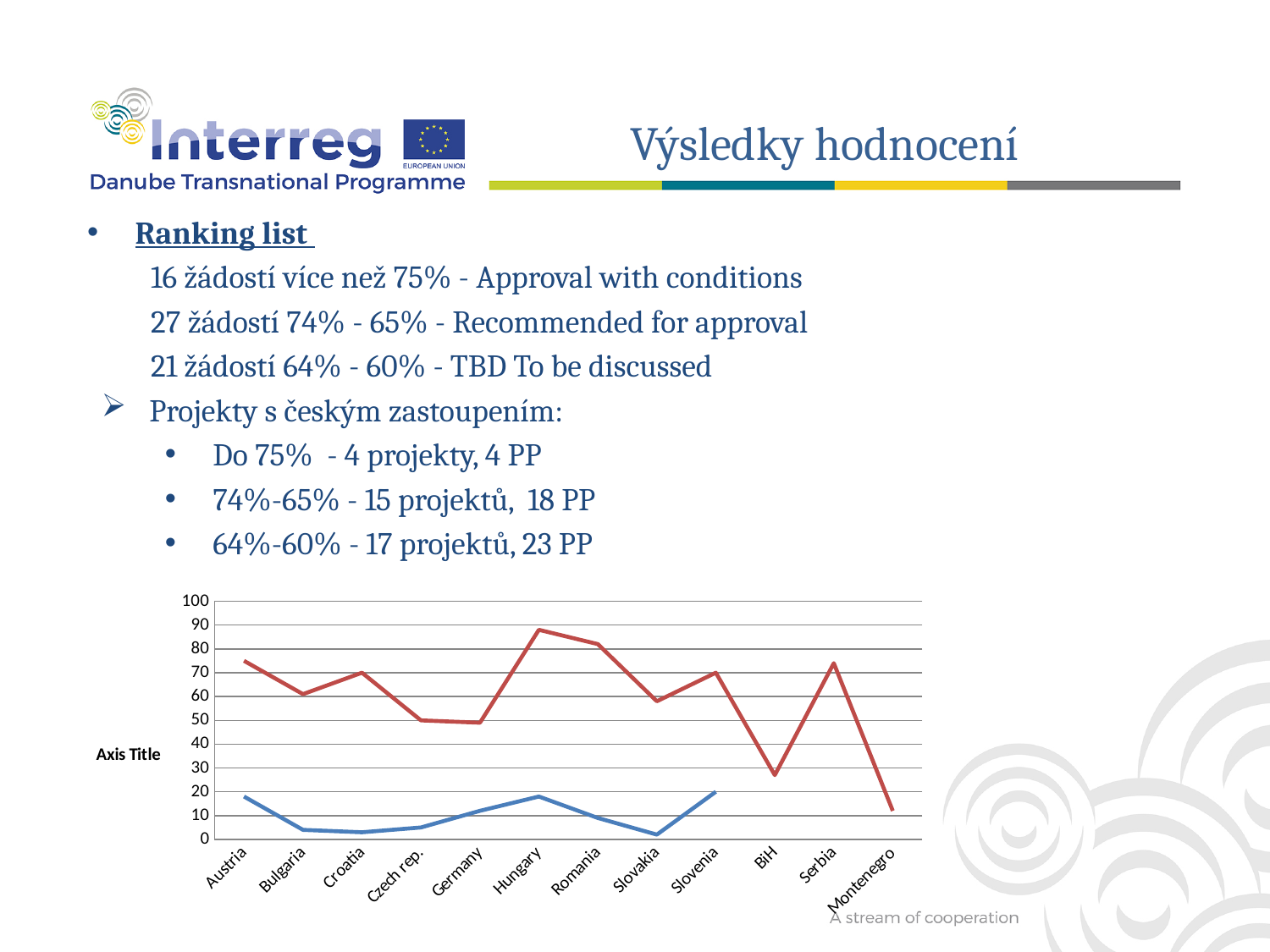
What kind of chart is shown on the slide? line chart Is the red line's value for BiH greater or less than 40? less For which country does the red line reach its highest value? Hungary Is the blue line's value for Slovakia greater or less than 10? less What is the title shown on the vertical axis of the chart? Axis Title How many countries are listed along the x axis of the chart? 12 On the red line, which is larger: the value for Romania or the value for Slovakia? Romania For which country does the red line reach its lowest value? Montenegro On the red line, which is larger: the value for Austria or the value for Bulgaria? Austria Is the red line's value for Czech rep. greater or less than 60? less